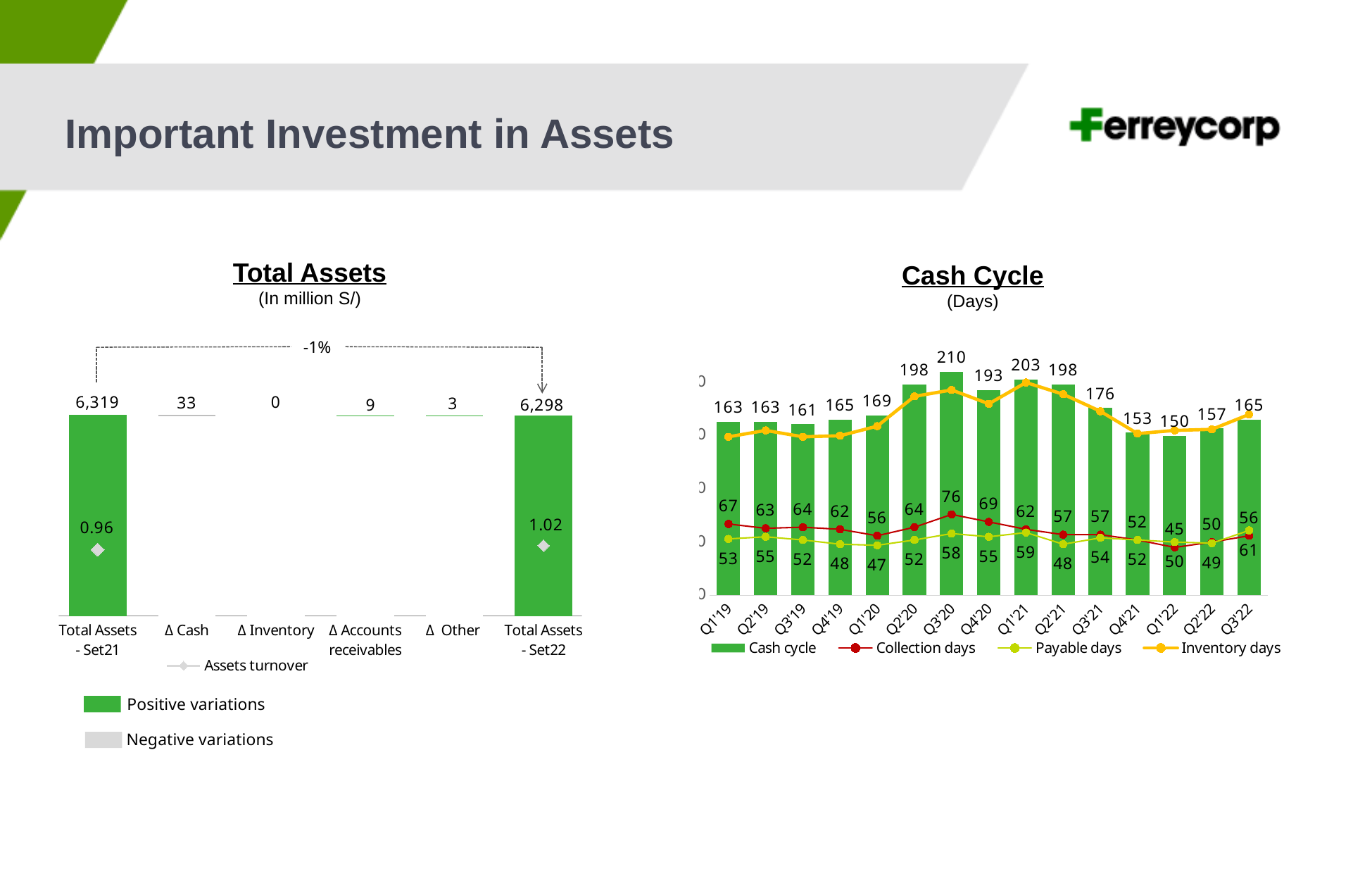
In the Cash Cycle chart, what is the collection days value for Q3'20? 76 In the Total Assets chart, what is the Assets turnover value shown for Set22? 1.02 In the Total Assets chart, what percentage change is shown between Set21 and Set22? -1% In the Total Assets chart, what is the value for Total Assets - Set21? 6,319 In the Cash Cycle chart, how many series does the legend list? 4 In the Cash Cycle chart, which quarter has the lowest collection days value? Q1'22 In the Cash Cycle chart, what is the difference between the cash cycle values for Q3'20 and Q1'22? 60 In the Cash Cycle chart, how many quarters are shown on the x axis? 15 In the Cash Cycle chart, what is the payable days value for Q3'22? 61 In the Cash Cycle chart, which quarter has the highest cash cycle value? Q3'20 In the Total Assets chart, what is the value for Total Assets - Set22? 6,298 In the Total Assets chart, what is the value shown for Δ Cash? 33